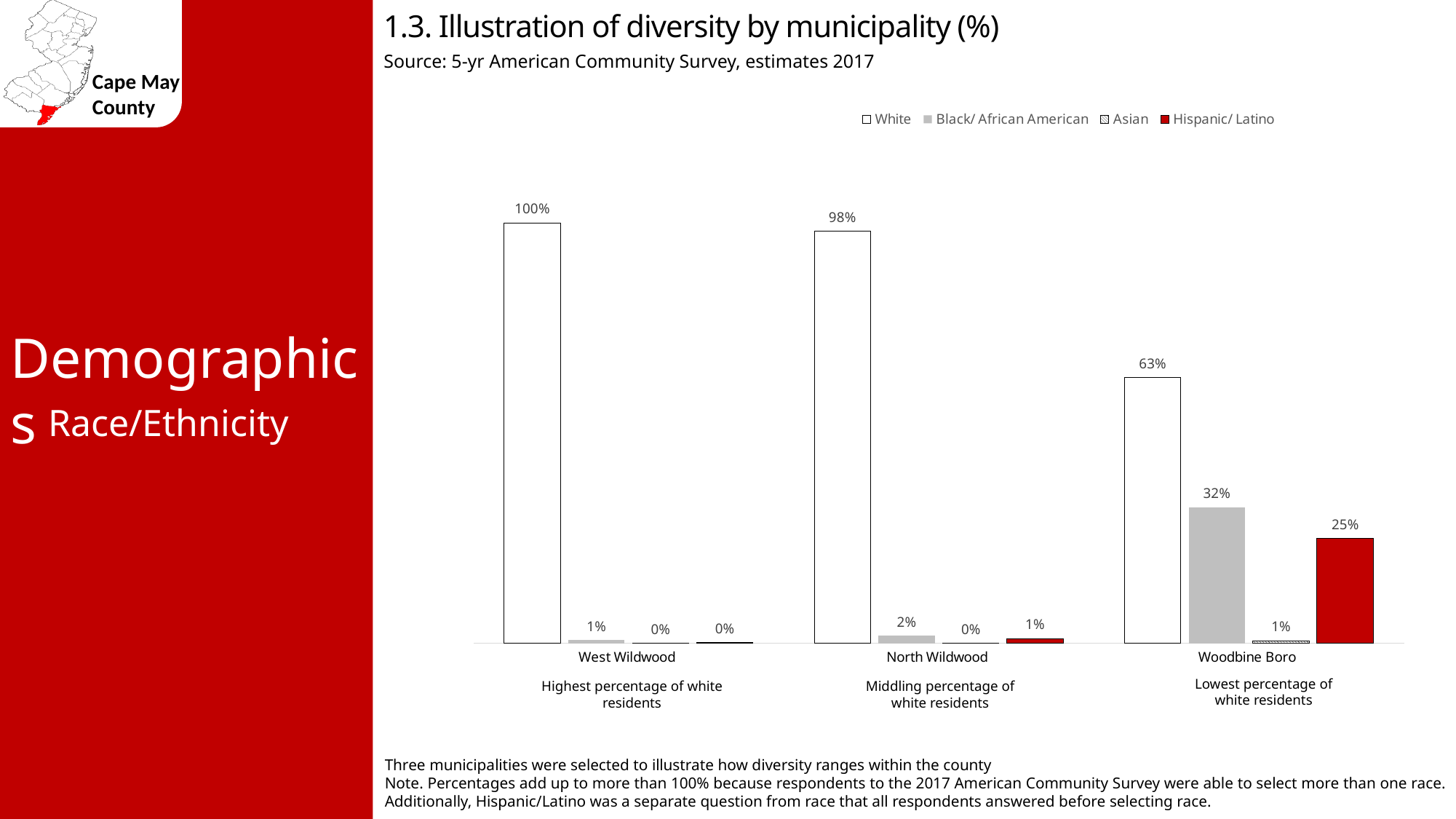
Which municipality has the highest value for Black/ African American? Woodbine Boro Which series is shown in red in the legend? Hispanic/ Latino What is the value for Black/ African American in North Wildwood? 2% What is the value for White in West Wildwood? 100% How many municipalities are shown on the chart? 3 What is the value for Hispanic/ Latino in Woodbine Boro? 25% Which municipality has the lowest value for White? Woodbine Boro What is the value for White in Woodbine Boro? 63% Which is larger in Woodbine Boro: the Black/ African American value or the Hispanic/ Latino value? Black/ African American What is the difference between the White value in West Wildwood and the White value in Woodbine Boro? 37% How many series does the legend list? 4 What kind of chart is shown on the slide? Bar chart